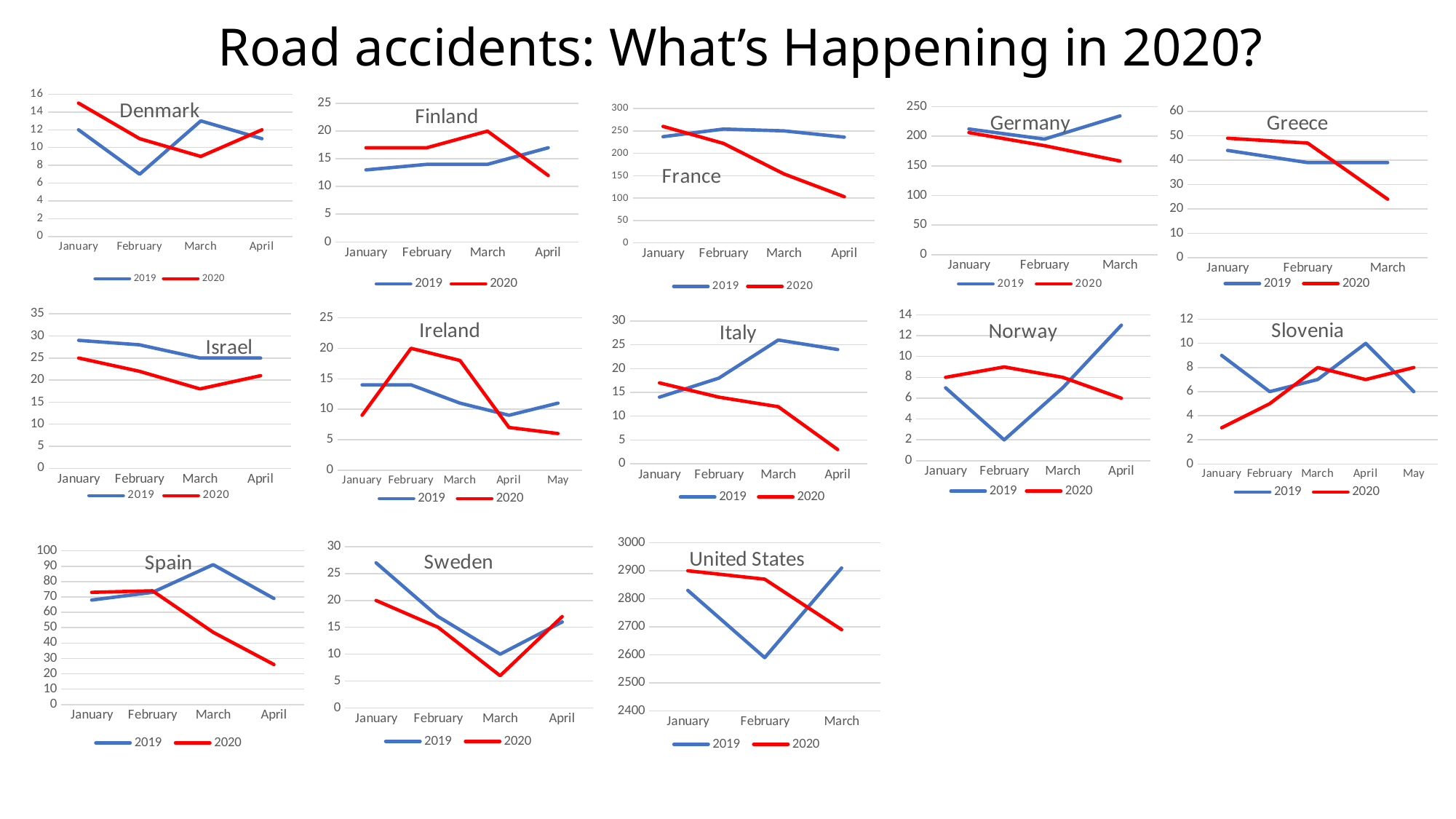
What kind of chart is the Denmark chart? line chart How many series does the legend of the Finland chart list? 2 In the Sweden chart, which month has the lowest 2019 value? March In the United States chart, is the 2019 value for February greater or less than 2700? less In the Germany chart, which series has the higher value in March, 2019 or 2020? 2019 In the Greece chart, which month has the lowest 2020 value? March How many months are shown on the x axis of the Ireland chart? 5 In the Italy chart, does the 2020 line rise or fall from January to April? fall In the Norway chart, which month has the lowest 2019 value? February In the Spain chart, is the 2019 value for March greater or less than 80? greater In the France chart, is the 2020 value for April greater or less than 150? less In the Slovenia chart, which month has the highest 2019 value? April